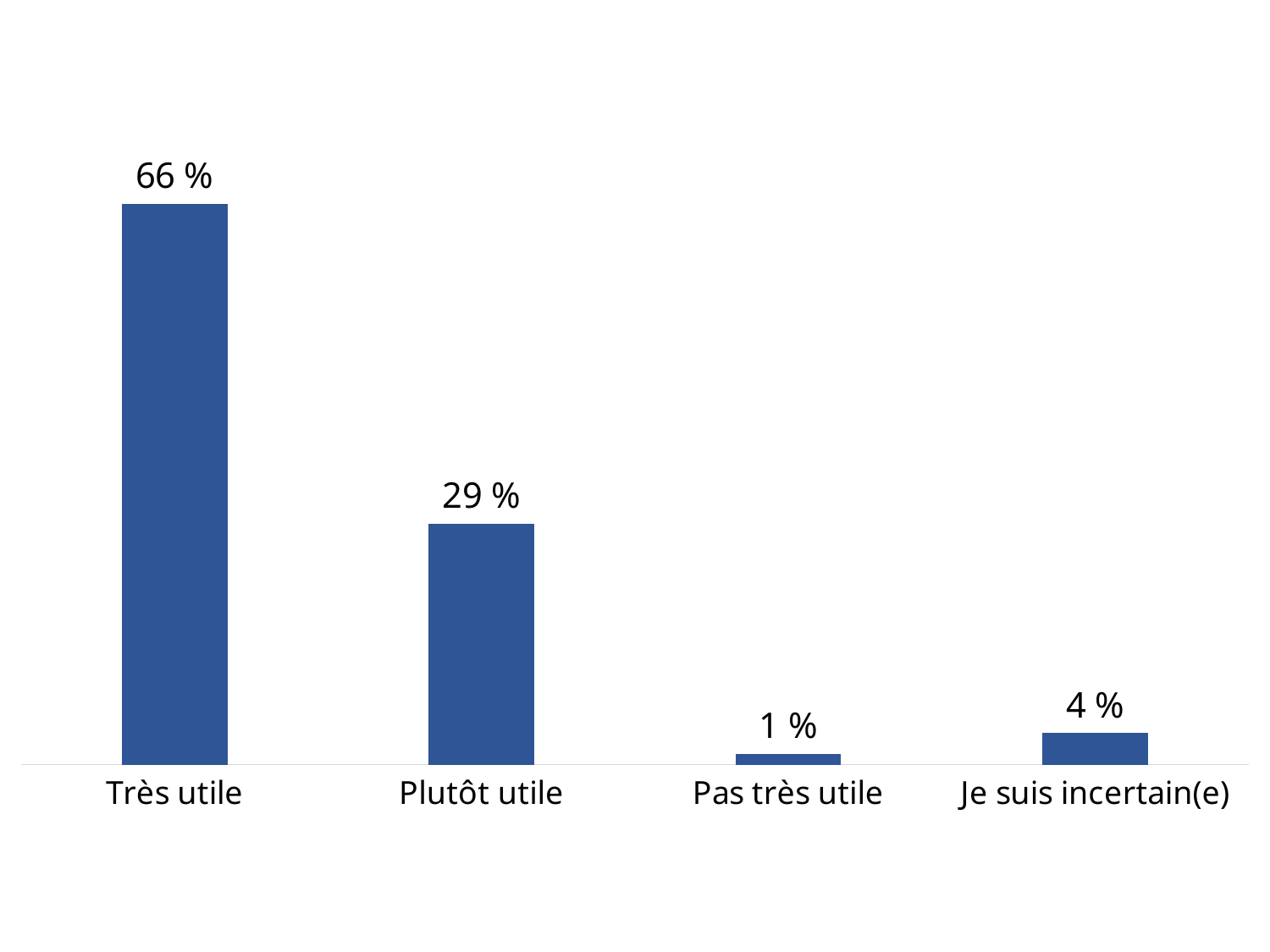
What colour are the bars in the chart? Blue What is the difference between the values for Je suis incertain(e) and Pas très utile? 3 % Which category has the highest value? Très utile What kind of chart is this? Bar chart What is the value for Pas très utile? 1 % How many categories are shown in the chart? 4 Which is larger, the value for Plutôt utile or the value for Je suis incertain(e)? Plutôt utile What is the difference between the values for Très utile and Plutôt utile? 37 % What is the value for Très utile? 66 % What is the value for Je suis incertain(e)? 4 % What is the value for Plutôt utile? 29 % Which category has the lowest value? Pas très utile